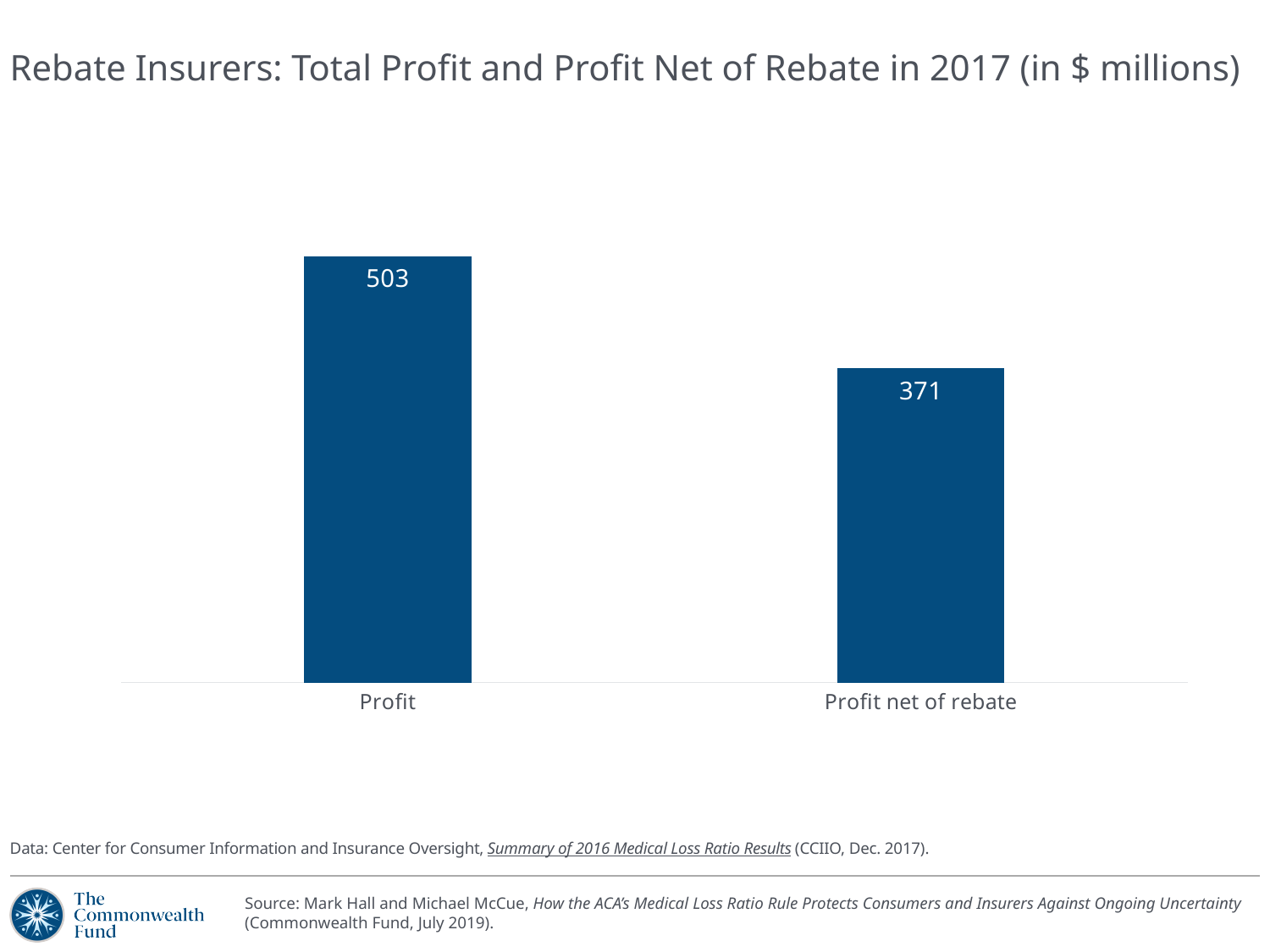
Do the values rise or fall from left to right across the categories? Fall What unit are the values in, according to the chart title? $ millions What is the difference between Profit and Profit net of rebate? 132 Which category has the lowest value? Profit net of rebate How many categories are shown in the chart? 2 What is the title of the chart? Rebate Insurers: Total Profit and Profit Net of Rebate in 2017 (in $ millions) What kind of chart is shown on the slide? Bar chart What is the value for Profit net of rebate? 371 What is the value for Profit? 503 Which category has the highest value? Profit Which is larger, Profit or Profit net of rebate? Profit